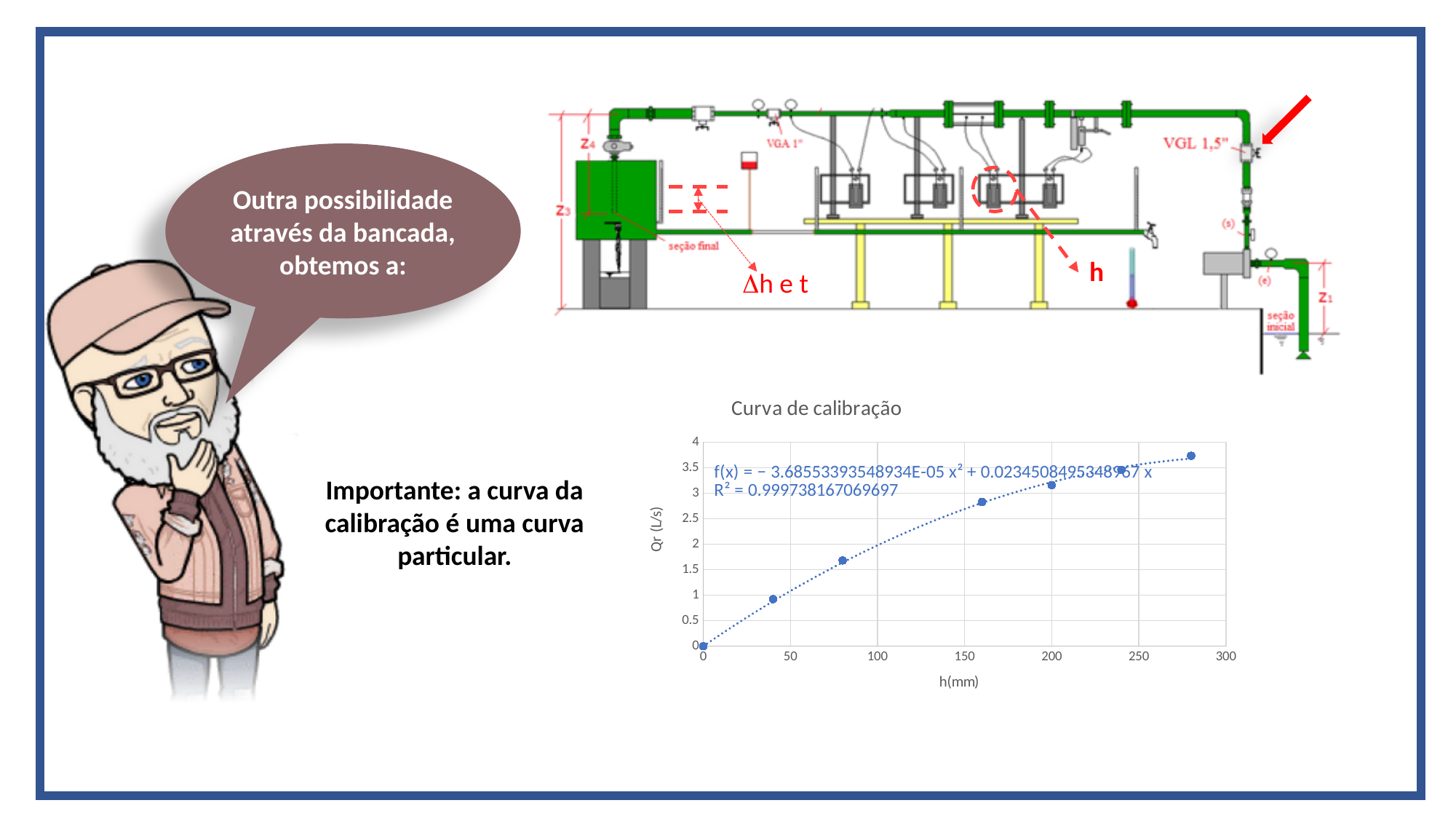
In the 'Curva de calibração' chart, which plotted point has the highest Qr value: the one at h = 200 mm or the one at h = 280 mm? h = 280 mm In the 'Curva de calibração' chart, is the value of Qr at h = 160 mm greater or less than 2.5? greater What is the label of the x axis of the 'Curva de calibração' chart? h(mm) In the 'Curva de calibração' chart, do the values of Qr rise or fall as h increases? rise What kind of chart is the 'Curva de calibração' chart? scatter chart What R² value is displayed for the trendline in the 'Curva de calibração' chart? 0.999738167069697 In the 'Curva de calibração' chart, is the value of Qr at h = 280 mm greater or less than 3.5? greater What is the title of the chart on the slide? Curva de calibração In the 'Curva de calibração' chart, is the value of Qr at h = 40 mm greater or less than 1? less How many data points are plotted in the 'Curva de calibração' chart? 7 What is the maximum value shown on the x axis of the 'Curva de calibração' chart? 300